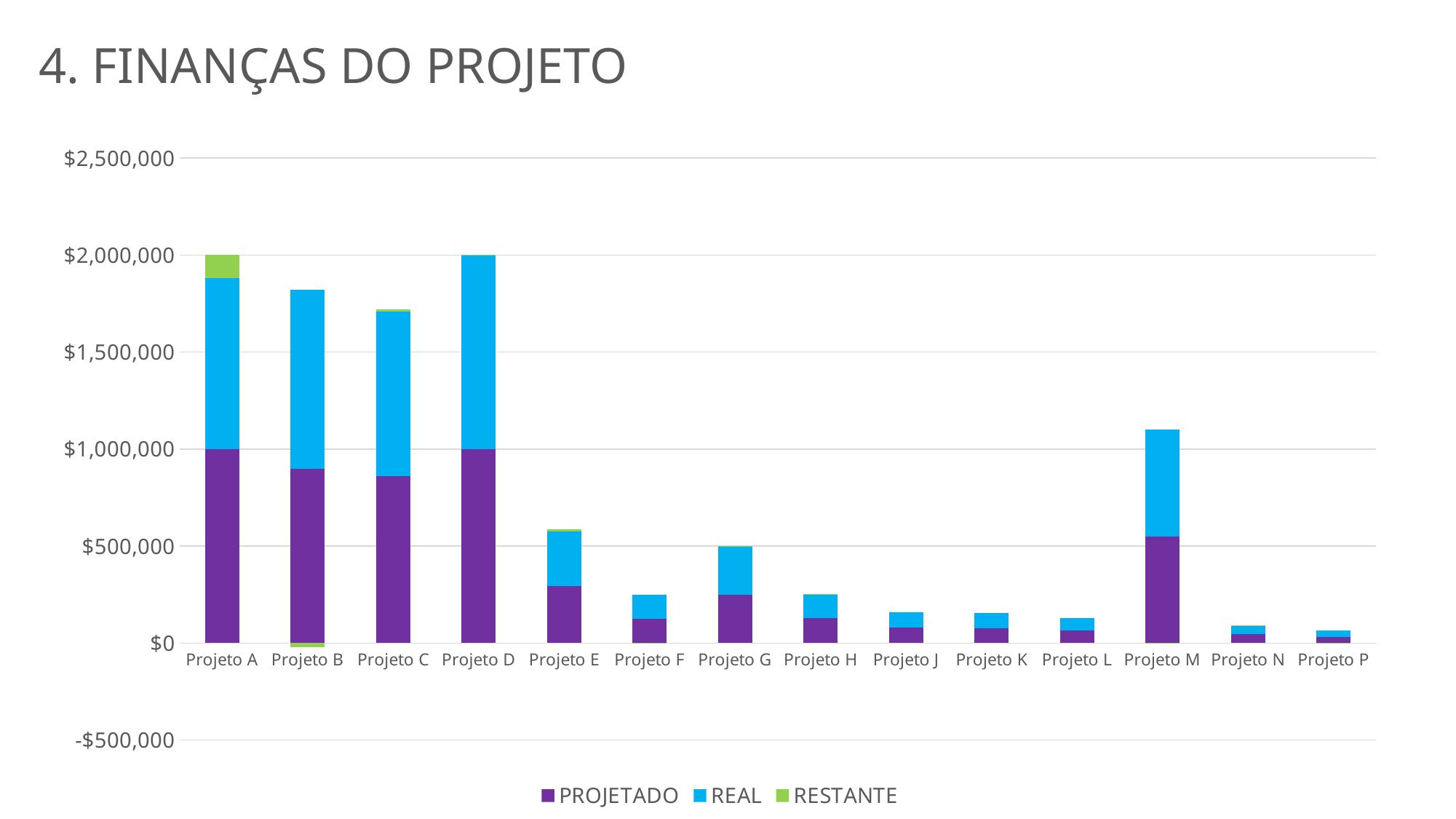
What kind of chart is shown on the slide? Stacked bar chart What is the PROJETADO value for Projeto A? $1,000,000 How many projects are shown on the x axis? 14 Is the total stacked value for Projeto F greater or less than $500,000? less Is the PROJETADO value for Projeto C greater or less than $1,000,000? less Which project has the lowest total stacked value? Projeto P Which project has the largest RESTANTE segment? Projeto A Which colour represents the REAL series in the legend? Blue What is the PROJETADO value for Projeto D? $1,000,000 Which has the larger total stacked value, Projeto M or Projeto E? Projeto M How many series does the legend list? 3 Is the total stacked value for Projeto M greater or less than $1,000,000? greater